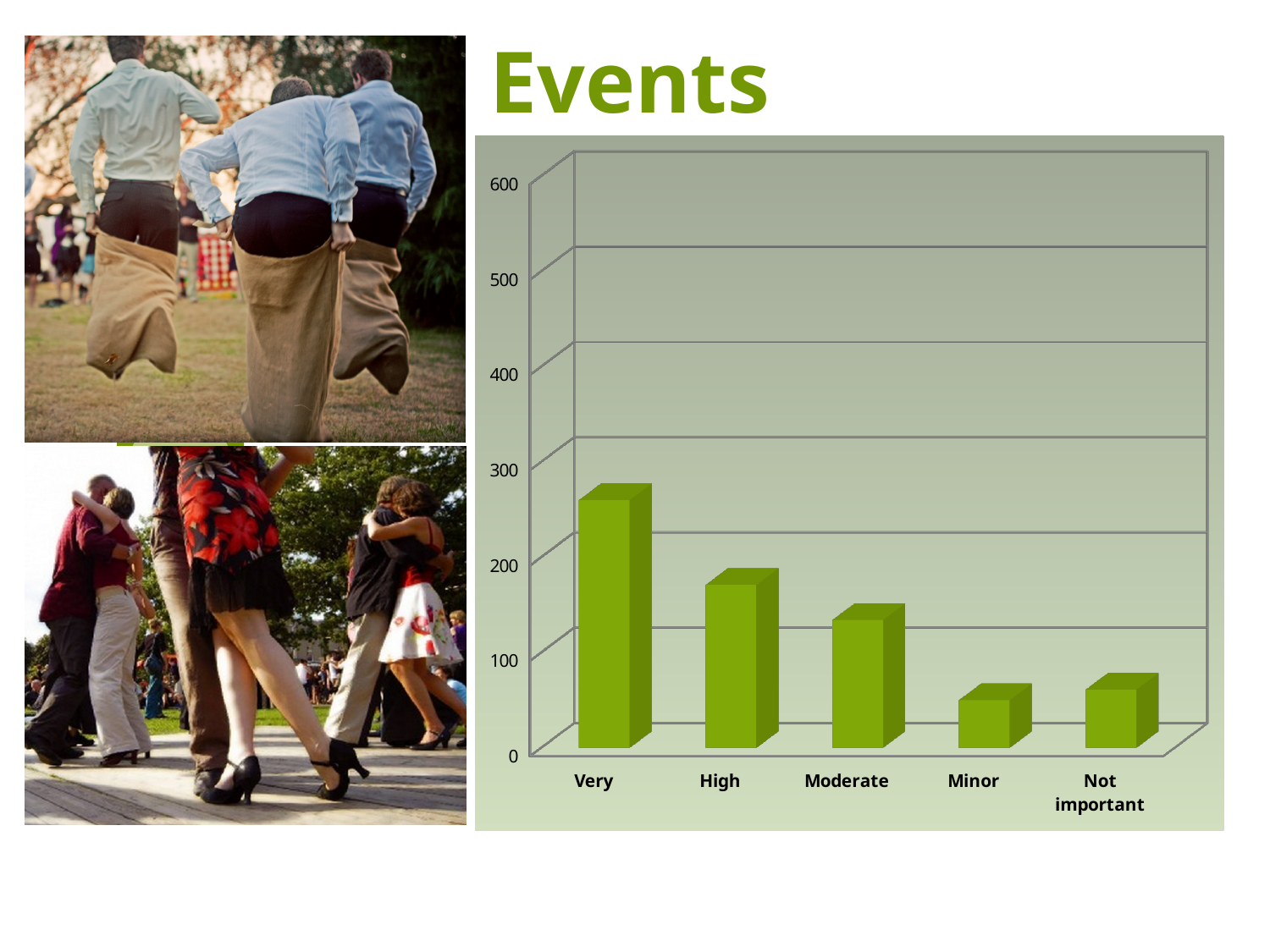
How many categories are shown on the x axis of the chart? 5 Is the value for Moderate greater or less than 100? greater What is the title of the chart? Events Is the value for Minor greater or less than 100? less Is the value for Very greater or less than 200? greater Which category has the highest value? Very Which is larger, the value for High or the value for Moderate? High Do the values rise or fall from Very to Minor along the x axis? fall What kind of chart is shown on the slide? bar chart Which category has the lowest value? Minor